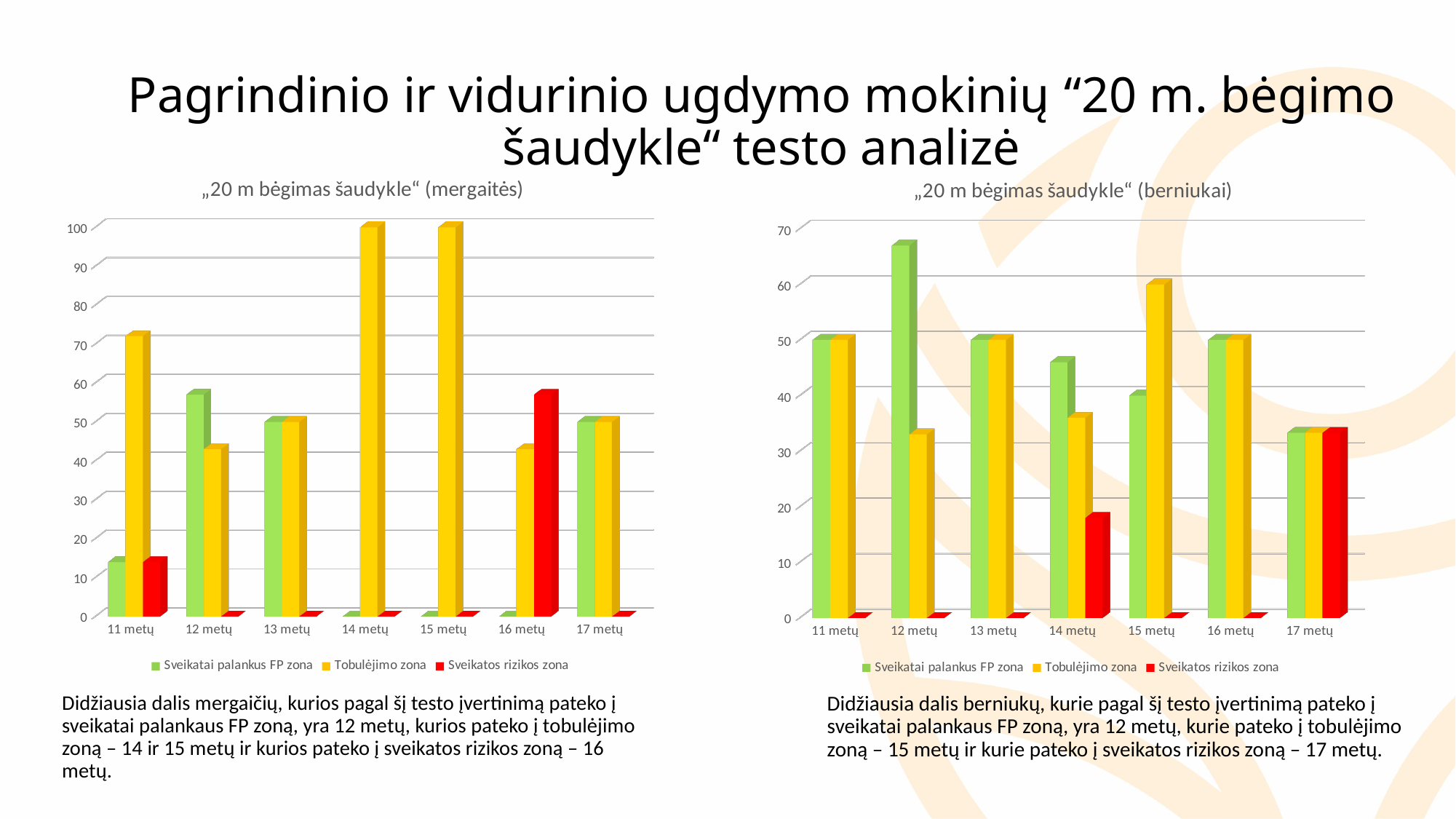
In the "20 m bėgimas šaudykle" (berniukai) chart, what is the value of Sveikatai palankus FP zona for 16 metų? 50 How many series does the legend of the "20 m bėgimas šaudykle" (berniukai) chart list? 3 What type of chart is the "20 m bėgimas šaudykle" (mergaitės) chart? Bar chart In the "20 m bėgimas šaudykle" (berniukai) chart, is the Sveikatos rizikos zona value for 14 metų greater or less than 20? less How many age groups are shown on the x axis of the "20 m bėgimas šaudykle" (mergaitės) chart? 7 In the "20 m bėgimas šaudykle" (mergaitės) chart, what is the value of Tobulėjimo zona for 14 metų? 100 In the "20 m bėgimas šaudykle" (berniukai) chart, which age group has the highest Sveikatai palankus FP zona value? 12 metų In the "20 m bėgimas šaudykle" (mergaitės) chart, is the Tobulėjimo zona value for 11 metų greater or less than 60? greater In the "20 m bėgimas šaudykle" (berniukai) chart, which is larger for 14 metų: Sveikatai palankus FP zona or Sveikatos rizikos zona? Sveikatai palankus FP zona In the "20 m bėgimas šaudykle" (mergaitės) chart, which age group has the highest Sveikatos rizikos zona value? 16 metų In the "20 m bėgimas šaudykle" (berniukai) chart, what is the value of Tobulėjimo zona for 15 metų? 60 In the "20 m bėgimas šaudykle" (mergaitės) chart, which is larger for 12 metų: Sveikatai palankus FP zona or Tobulėjimo zona? Sveikatai palankus FP zona